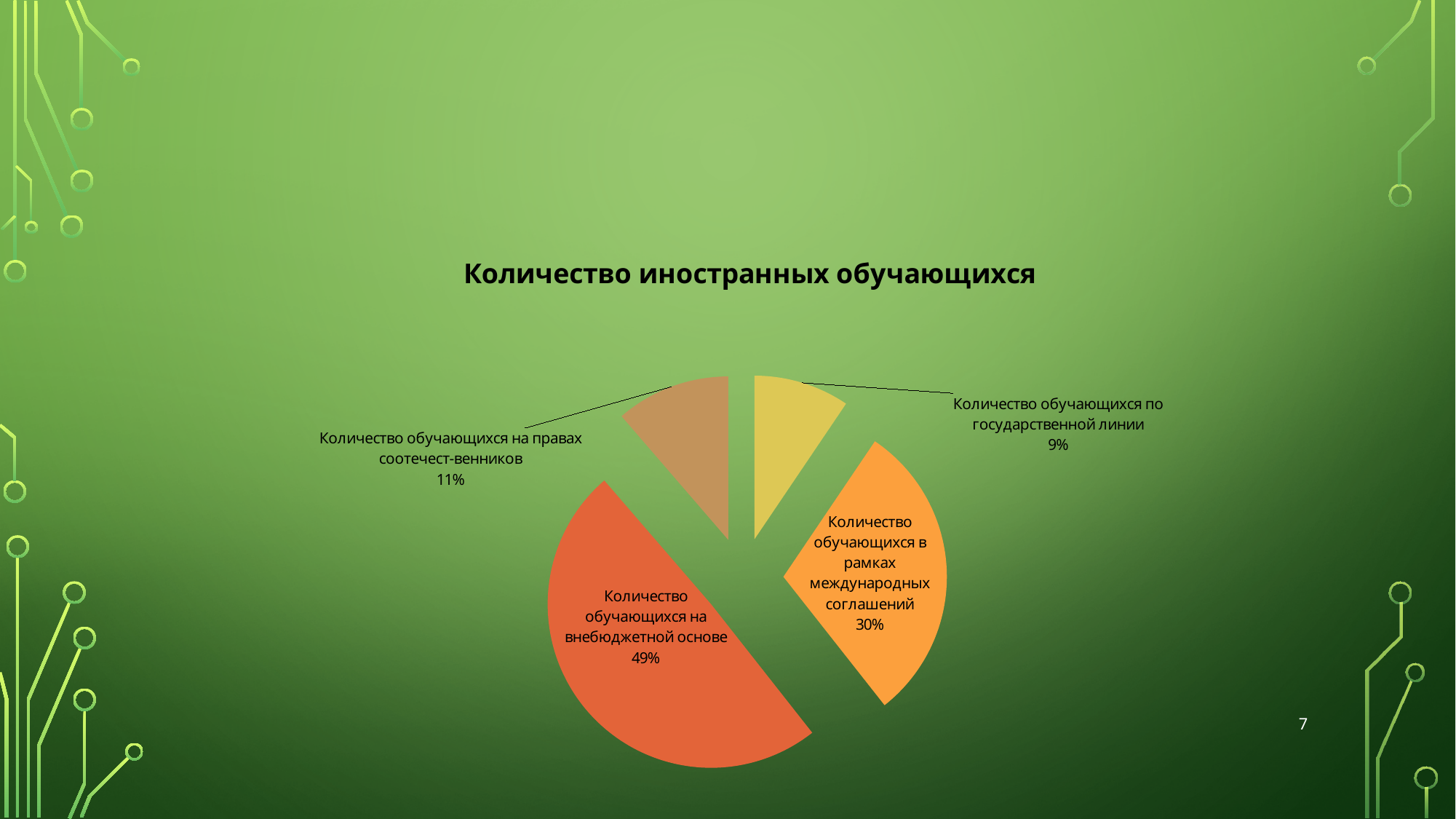
What share of the pie is 'Количество обучающихся на правах соотечест-венников'? 11% What type of chart is shown on the slide? pie chart What share of the pie is 'Количество обучающихся в рамках международных соглашений'? 30% What share of the pie is 'Количество обучающихся на внебюджетной основе'? 49% Which category has the largest share of the pie? Количество обучающихся на внебюджетной основе Which is larger: the share for 'Количество обучающихся на правах соотечест-венников' or for 'Количество обучающихся по государственной линии'? Количество обучающихся на правах соотечест-венников What is the title of the chart? Количество иностранных обучающихся Which category has the smallest share of the pie? Количество обучающихся по государственной линии What is the difference in percentage points between 'Количество обучающихся на внебюджетной основе' and 'Количество обучающихся в рамках международных соглашений'? 19 How many slices does the pie chart have? 4 What colour is the slice for 'Количество обучающихся по государственной линии'? yellow